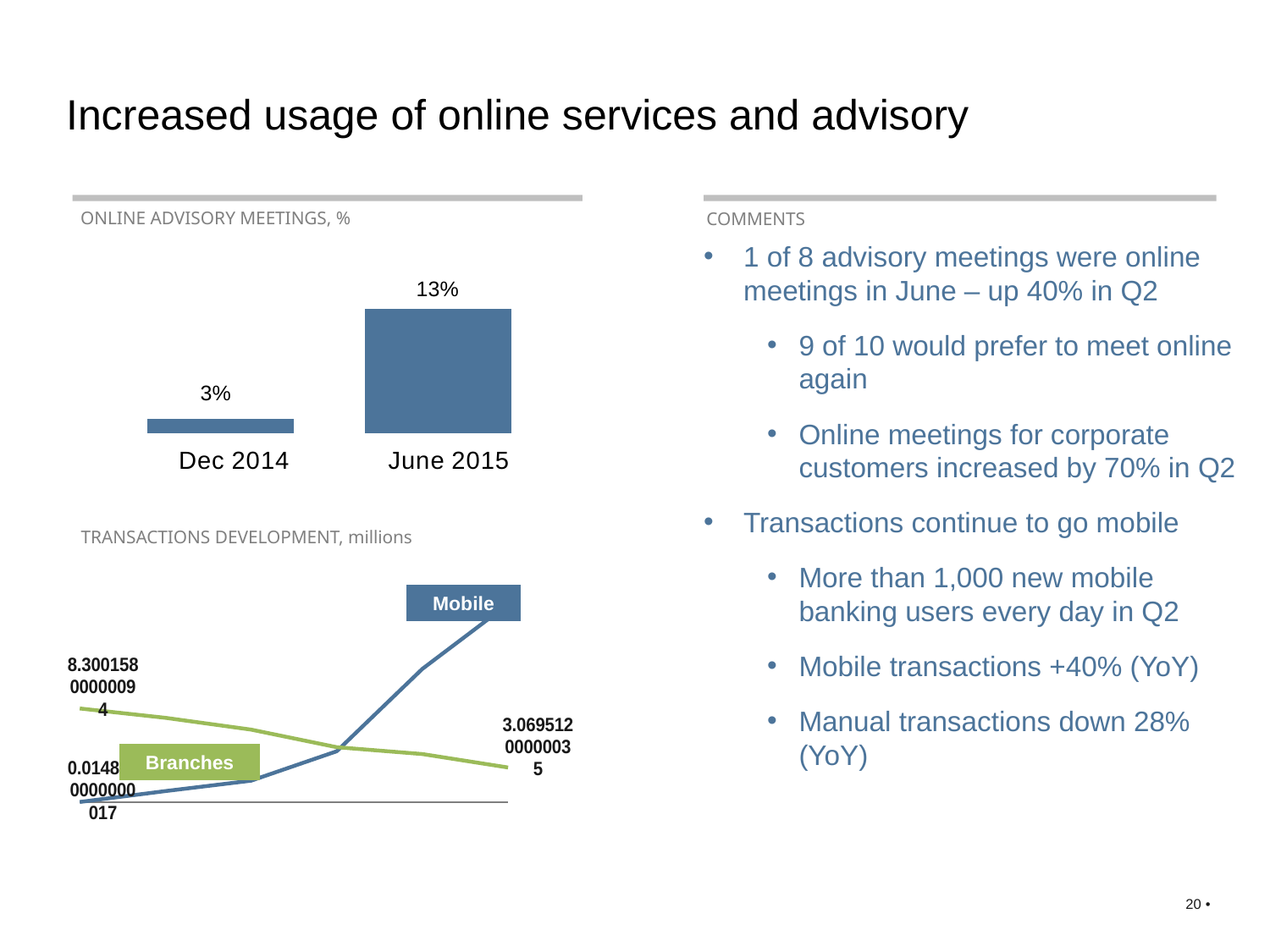
How many series are shown in the TRANSACTIONS DEVELOPMENT chart? 2 In the ONLINE ADVISORY MEETINGS chart, what is the difference between the June 2015 and Dec 2014 values? 10% In the ONLINE ADVISORY MEETINGS chart, which period has the higher value? June 2015 What type of chart is the TRANSACTIONS DEVELOPMENT chart? Line chart In the ONLINE ADVISORY MEETINGS chart, do the values rise or fall from Dec 2014 to June 2015? Rise How many categories are shown in the ONLINE ADVISORY MEETINGS chart? 2 What type of chart is the ONLINE ADVISORY MEETINGS chart? Bar chart In the TRANSACTIONS DEVELOPMENT chart, does the Mobile line rise or fall over time? Rise In the TRANSACTIONS DEVELOPMENT chart, which series is higher at the right end of the chart, Mobile or Branches? Mobile In the TRANSACTIONS DEVELOPMENT chart, does the Branches line rise or fall over time? Fall In the ONLINE ADVISORY MEETINGS chart, what is the value for June 2015? 13% In the ONLINE ADVISORY MEETINGS chart, what is the value for Dec 2014? 3%